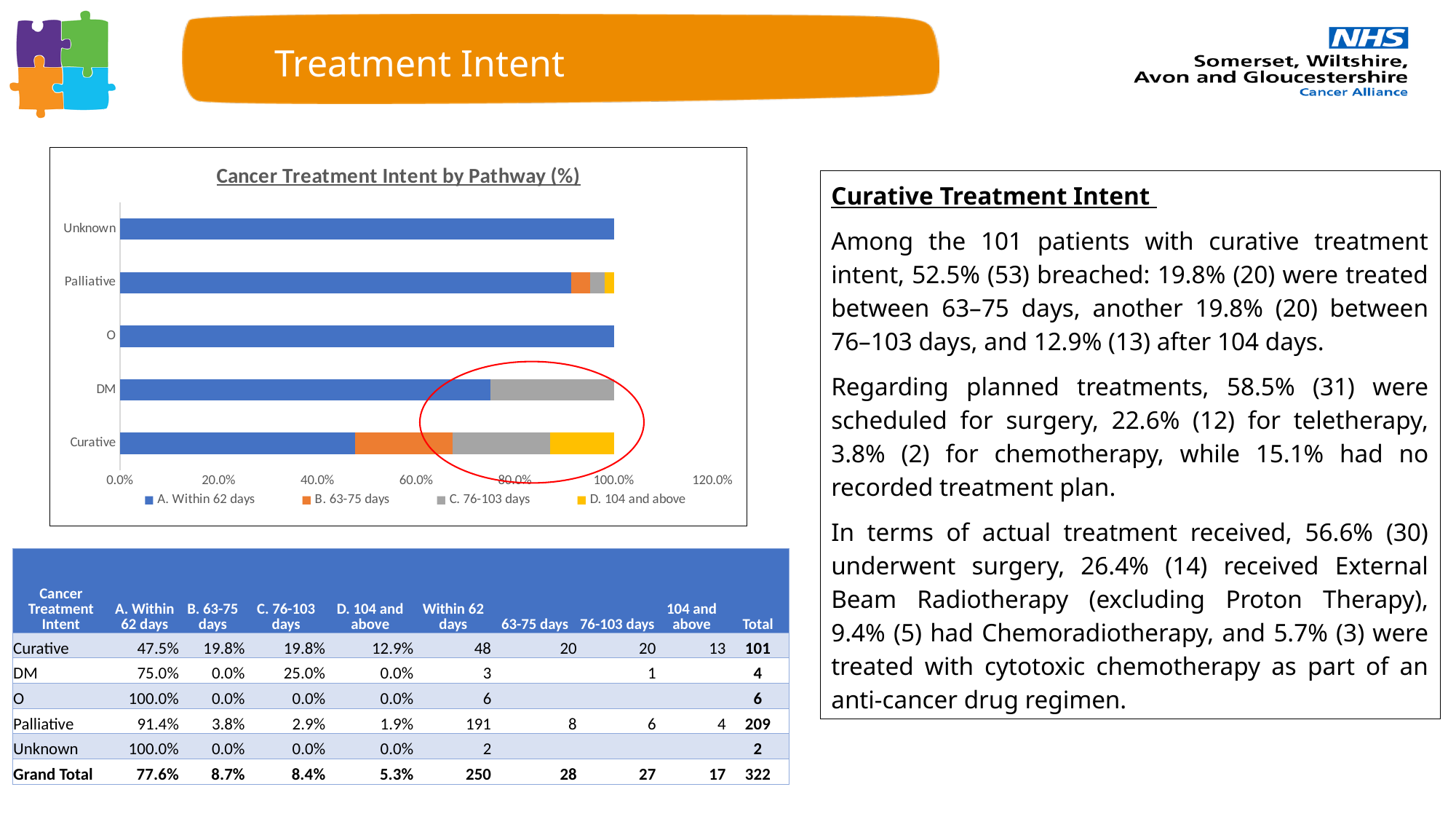
What colour represents 'D. 104 and above' in the chart? yellow What is the title of the chart? Cancer Treatment Intent by Pathway (%) Which category has the lowest share treated within 62 days? Curative Is the 'A. Within 62 days' value for Curative greater or less than 60.0%? less For Curative, what is the difference between the 'B. 63-75 days' share and the 'D. 104 and above' share? 6.9% Is the 'A. Within 62 days' value for Palliative greater or less than 80.0%? greater How many series does the legend of the chart list? 4 How many treatment intent categories are plotted on the chart? 5 Which has a larger share treated within 62 days, DM or Palliative? Palliative What kind of chart is shown on the slide? bar chart What percentage of DM patients were treated in 76-103 days? 25.0% What percentage of Curative patients were treated within 62 days? 47.5%